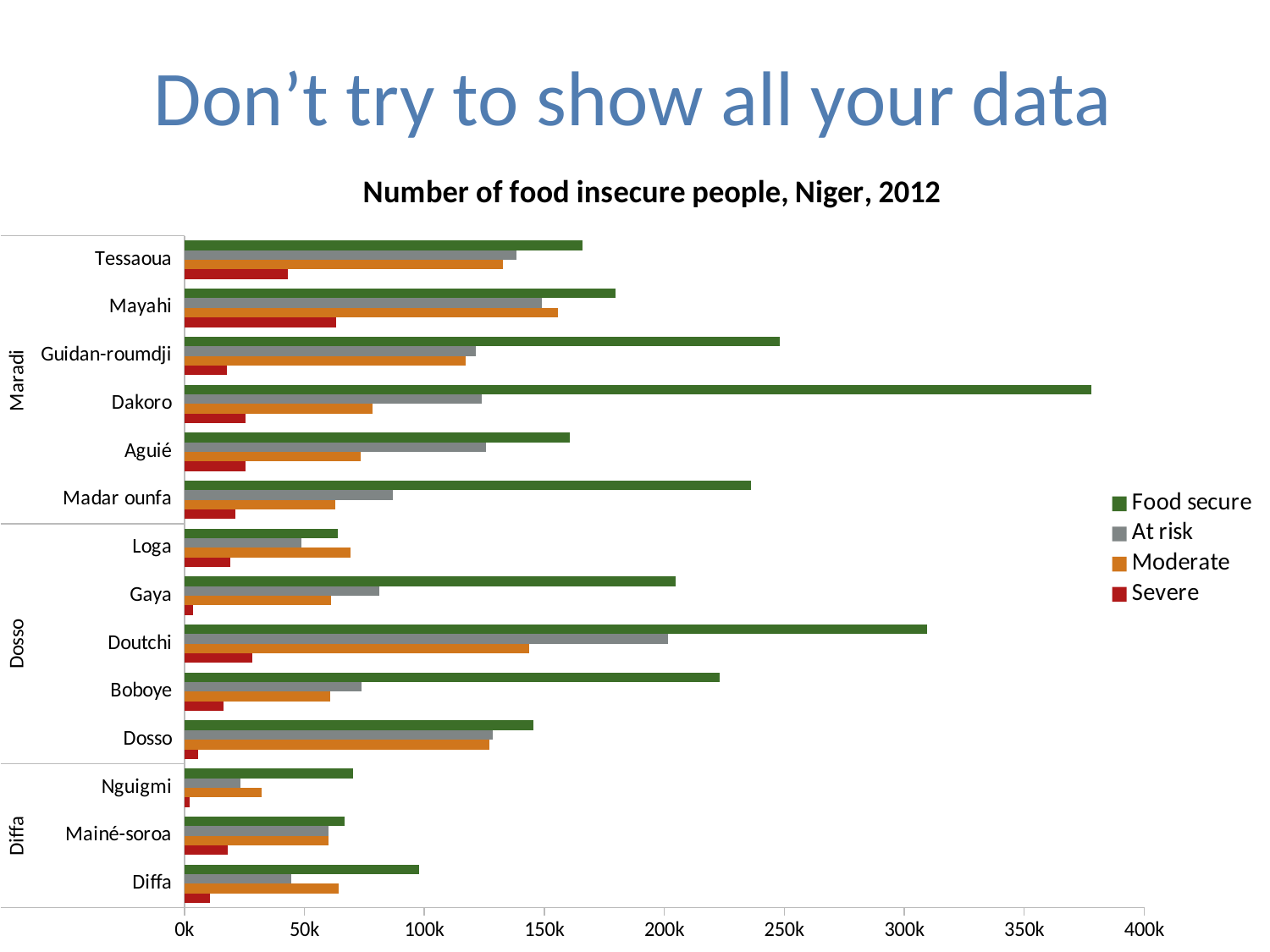
Is the Food secure value for Dakoro greater or less than 350k? greater Which department has the highest Severe value? Mayahi Which department has the highest At risk value? Doutchi Which department has the highest Food secure value? Dakoro Which is larger, the At risk value for Doutchi or the At risk value for Gaya? Doutchi How many series does the legend list? 4 What is the title of the chart? Number of food insecure people, Niger, 2012 Is the Food secure value for Nguigmi greater or less than 100k? less How many departments (categories) are plotted on the chart? 14 What kind of chart is shown on the slide? bar chart Which three regions are the departments grouped into on the vertical axis? Maradi, Dosso, Diffa Is the Food secure value for Doutchi greater or less than 250k? greater